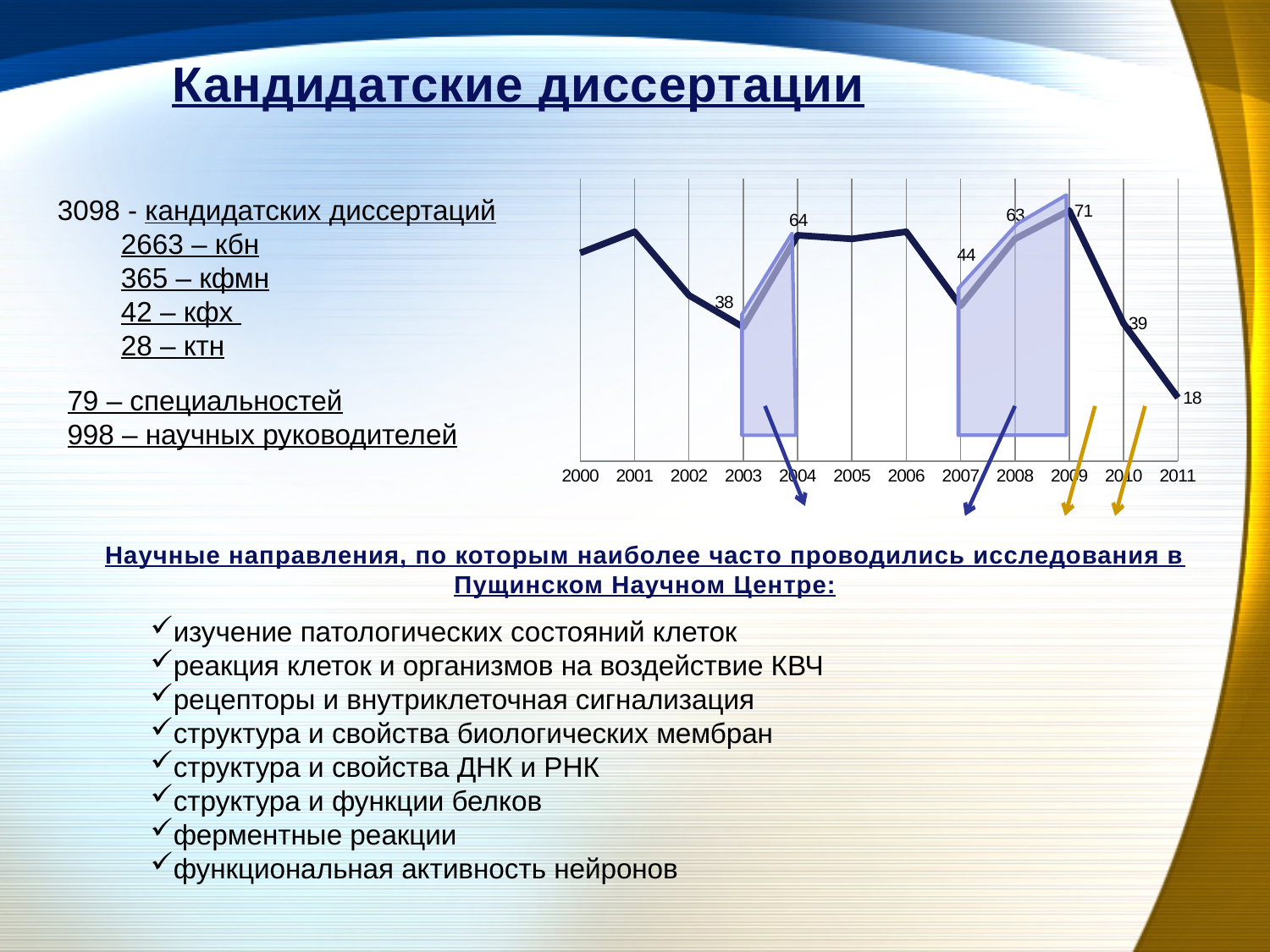
What is the difference between the values for 2004 and 2003? 26 Which year has the highest value on the chart? 2009 Which year has the lowest value on the chart? 2011 What kind of chart is shown on the slide? line chart How many years are shown on the x axis of the chart? 12 Which is larger, the value for 2009 or the value for 2010? 2009 What is the difference between the values for 2009 and 2011? 53 What is the value for 2003? 38 What is the value for 2009? 71 What is the value for 2004? 64 What is the value for 2011? 18 What is the value for 2007? 44